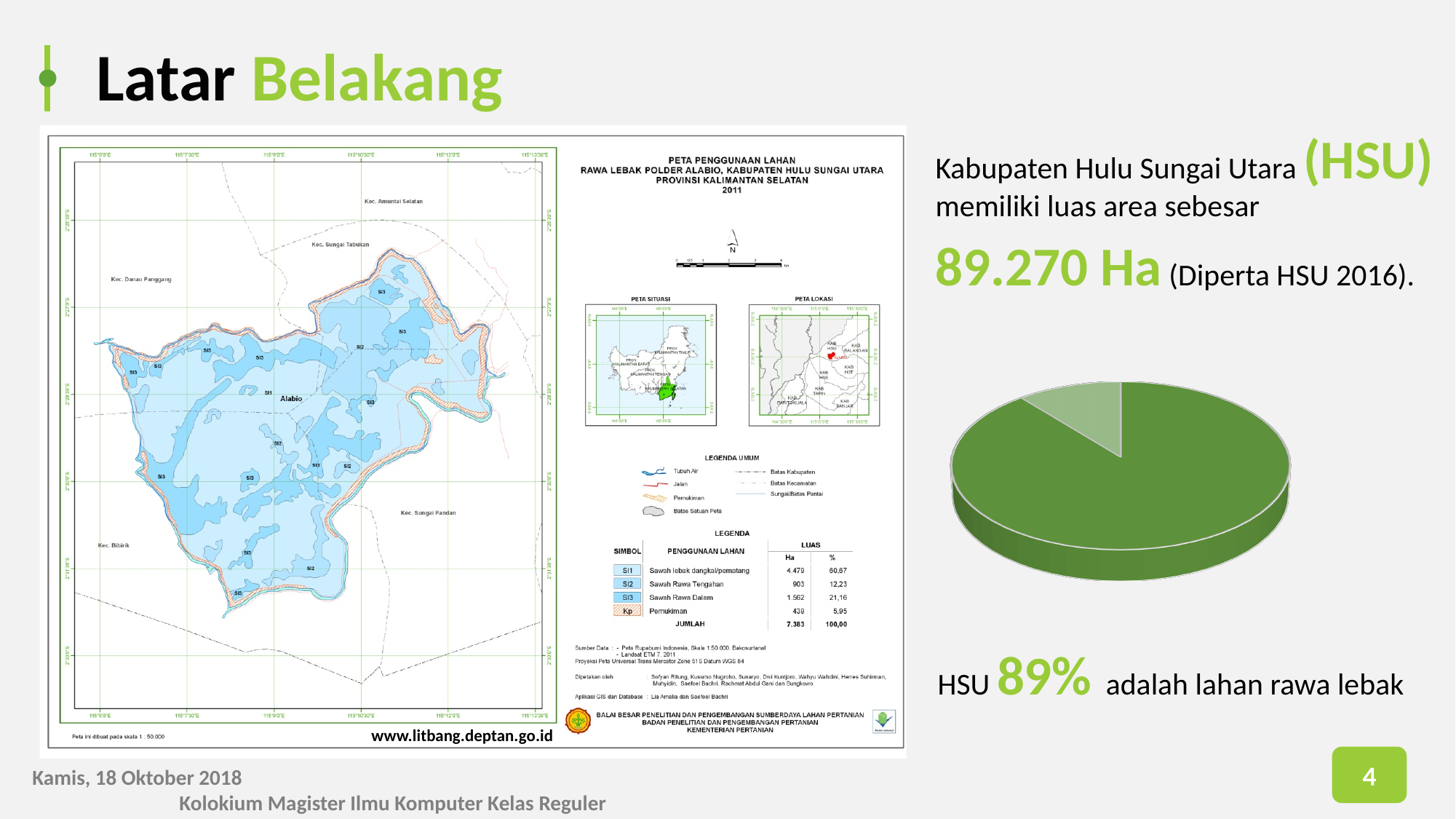
What colour is the largest slice of the pie chart on the right side of the slide? dark green What kind of chart is shown on the right side of the slide? pie chart According to the text below the pie chart, what share of HSU is lahan rawa lebak? 89% In the pie chart on the right side of the slide, which slice is the smallest? the light green slice How many slices does the pie chart on the right side of the slide have? 2 Does the pie chart on the right side of the slide have a legend? No In the pie chart on the right side of the slide, which slice is larger, the dark green slice or the light green slice? the dark green slice